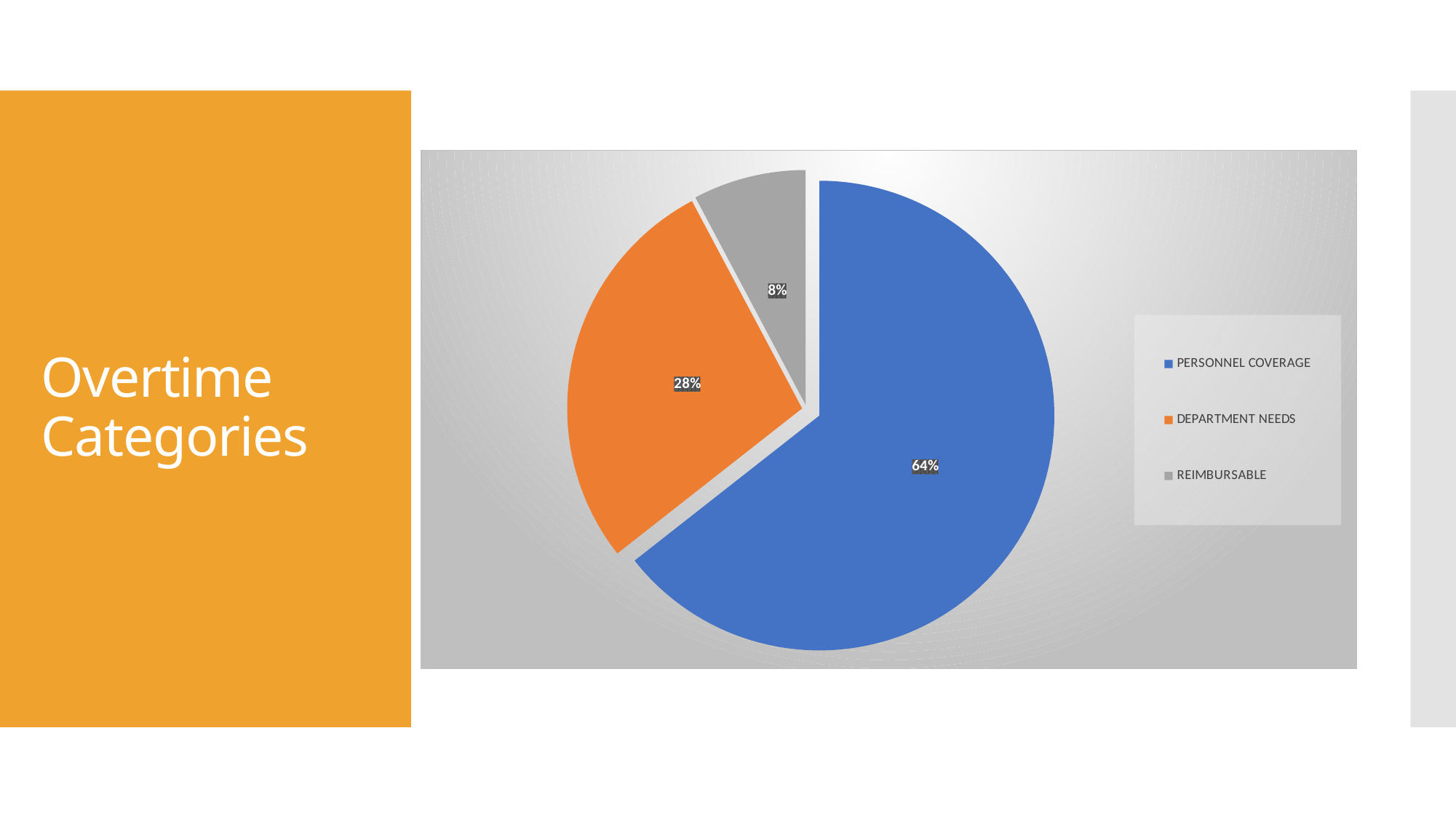
What is the title of the slide containing the chart? Overtime Categories Which is larger, the Department Needs slice or the Reimbursable slice? Department Needs What is the difference in percentage points between Department Needs and Reimbursable? 20 Which category has the smallest slice of the pie? Reimbursable What share of the pie does Reimbursable represent? 8% What is the difference in percentage points between Personnel Coverage and Department Needs? 36 What type of chart is shown on the slide? pie chart What colour is the Department Needs slice? orange How many categories are shown in the pie chart? 3 What share of the pie does Department Needs represent? 28% Which category has the largest slice of the pie? Personnel Coverage What share of the pie does Personnel Coverage represent? 64%